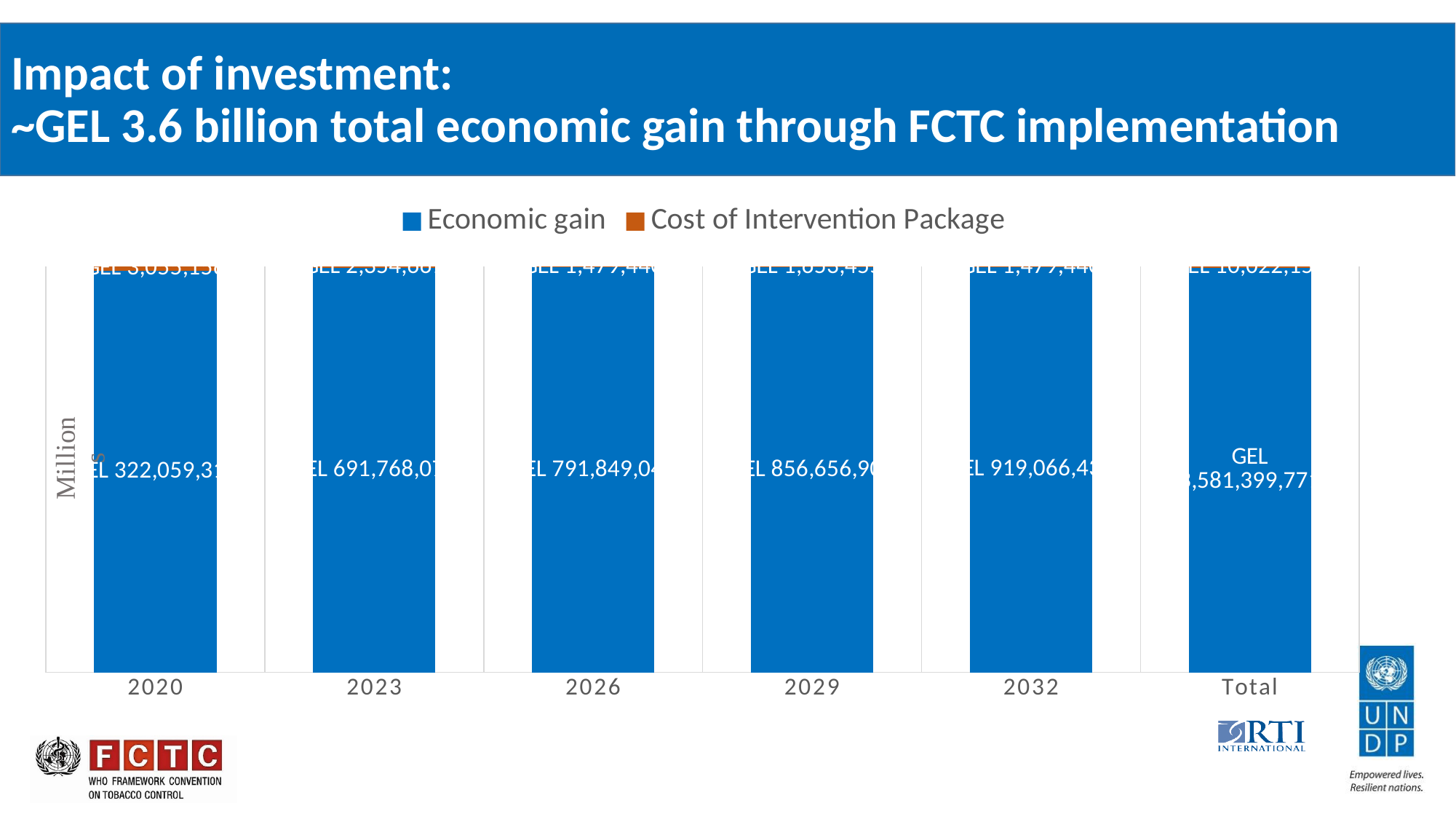
Which category on the x axis has the highest Economic gain? Total Which year has the lowest Economic gain? 2020 What are the two series named in the chart legend? Economic gain and Cost of Intervention Package What is the last category shown on the x axis of the chart? Total Is the Economic gain larger in 2029 or in 2032? 2032 How many series does the chart legend list? 2 What kind of chart is shown on the slide? bar chart How many categories are shown along the x axis of the chart? 6 Is the Economic gain larger in 2023 or in 2026? 2026 What is the label on the vertical axis of the chart? Million Does the Economic gain rise or fall from 2020 to 2032? rise Among the years 2020 to 2032, which year has the highest Economic gain? 2032